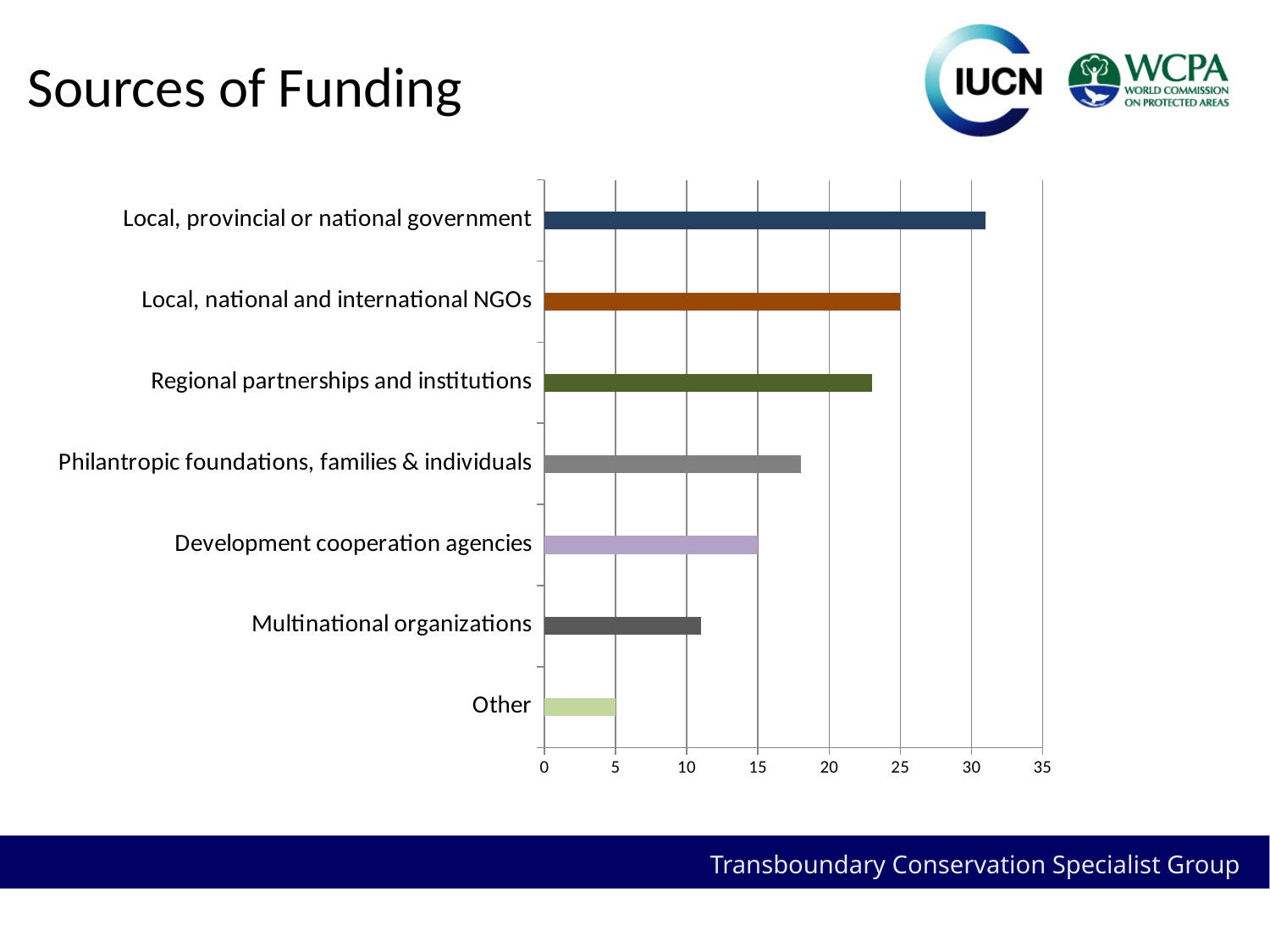
Is the value for Regional partnerships and institutions greater or less than 25? less What is the value for Development cooperation agencies? 15 Which funding source has the highest value? Local, provincial or national government How many funding source categories are shown in the chart? 7 Which is larger: the value for Philantropic foundations, families & individuals or the value for Development cooperation agencies? Philantropic foundations, families & individuals Which funding source has the lowest value? Other Is the value for Local, provincial or national government greater or less than 30? greater Is the value for Multinational organizations greater or less than 10? greater What is the value for Local, national and international NGOs? 25 What kind of chart is shown on the slide? bar chart What is the value for Other? 5 What is the title of the slide containing the chart? Sources of Funding